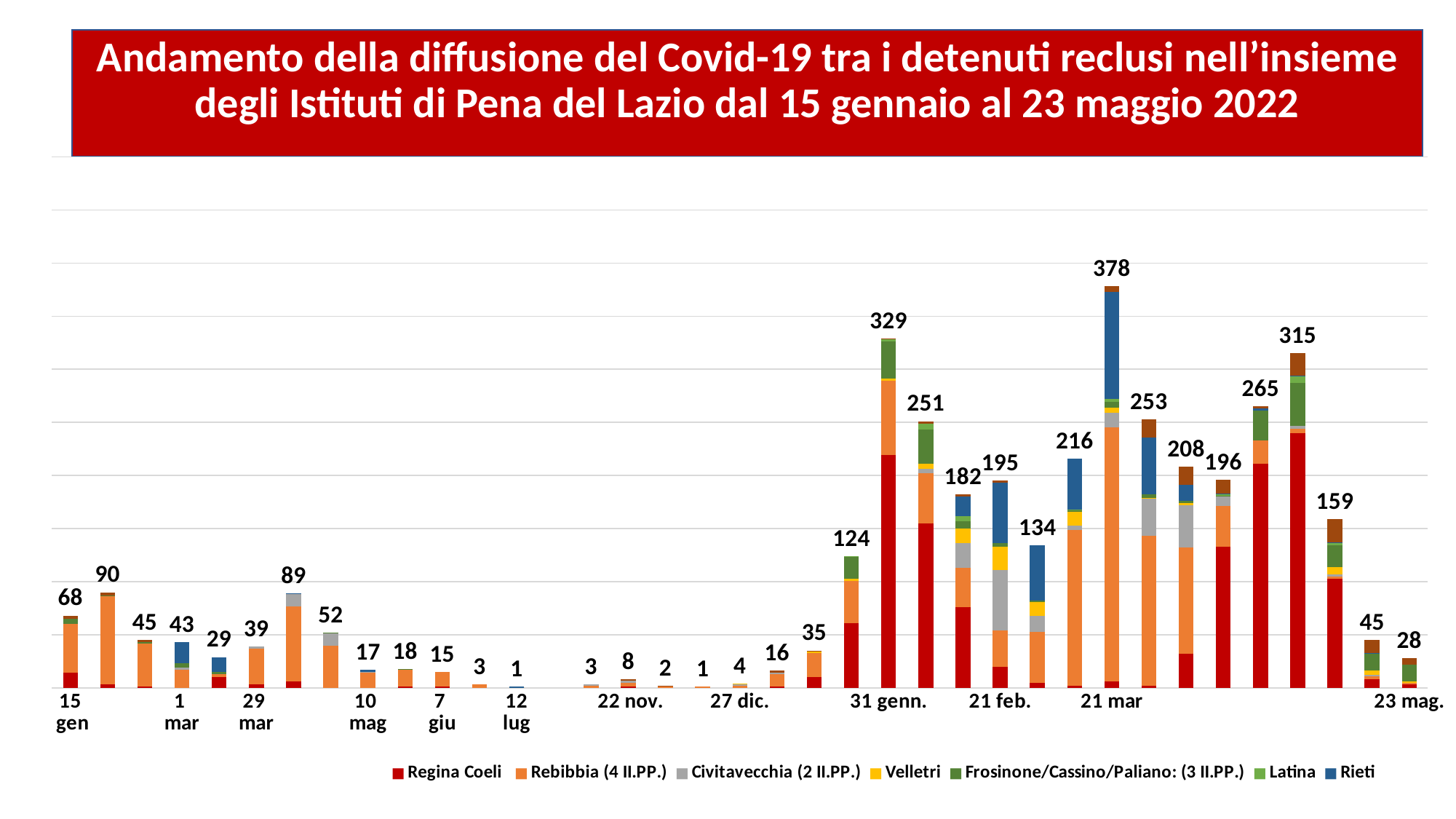
Which date has the highest total number of cases? 21 mar How many series does the legend list? 7 Which has a larger total, 31 genn. or 21 feb.? 31 genn. What is the total number of cases shown for 15 gen? 68 What kind of chart is shown on the slide? Stacked bar chart What is the total number of cases shown for 12 lug? 1 What is the total number of cases shown for 23 mag.? 28 What is the total number of cases shown for 21 mar? 378 What is the difference between the total for 15 gen and the total for 23 mag.? 40 What is the difference between the total for 21 mar and the total for 31 genn.? 49 Which series is listed first in the legend? Regina Coeli